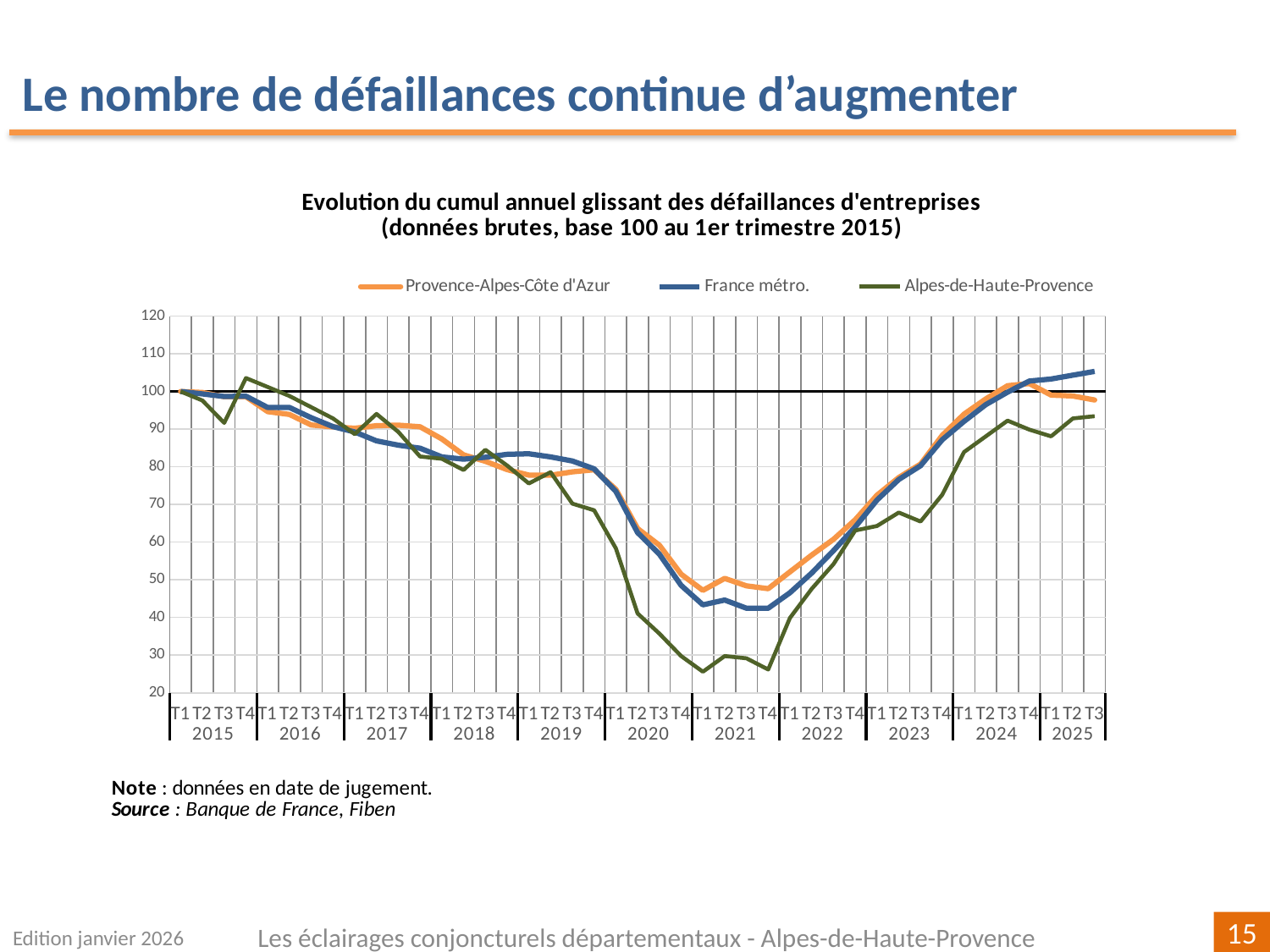
Which series has the highest value at T3 2025? France métro. Which series reaches the lowest point on the chart? Alpes-de-Haute-Provence Do the values for France métro. rise or fall between T1 2022 and T4 2024? rise How many years are labelled along the x axis? 11 Is the value for Alpes-de-Haute-Provence at T1 2021 greater or less than 30? less What kind of chart is shown on the slide? line chart Is the value for Provence-Alpes-Côte d'Azur at T3 2025 greater or less than 100? less Which series is shown in green in the legend? Alpes-de-Haute-Provence At T1 2021, which is larger: the value for Provence-Alpes-Côte d'Azur or for Alpes-de-Haute-Provence? Provence-Alpes-Côte d'Azur What is the value of all three series at T1 2015? 100 How many series does the legend list? 3 Is the value for France métro. at T3 2025 greater or less than 100? greater